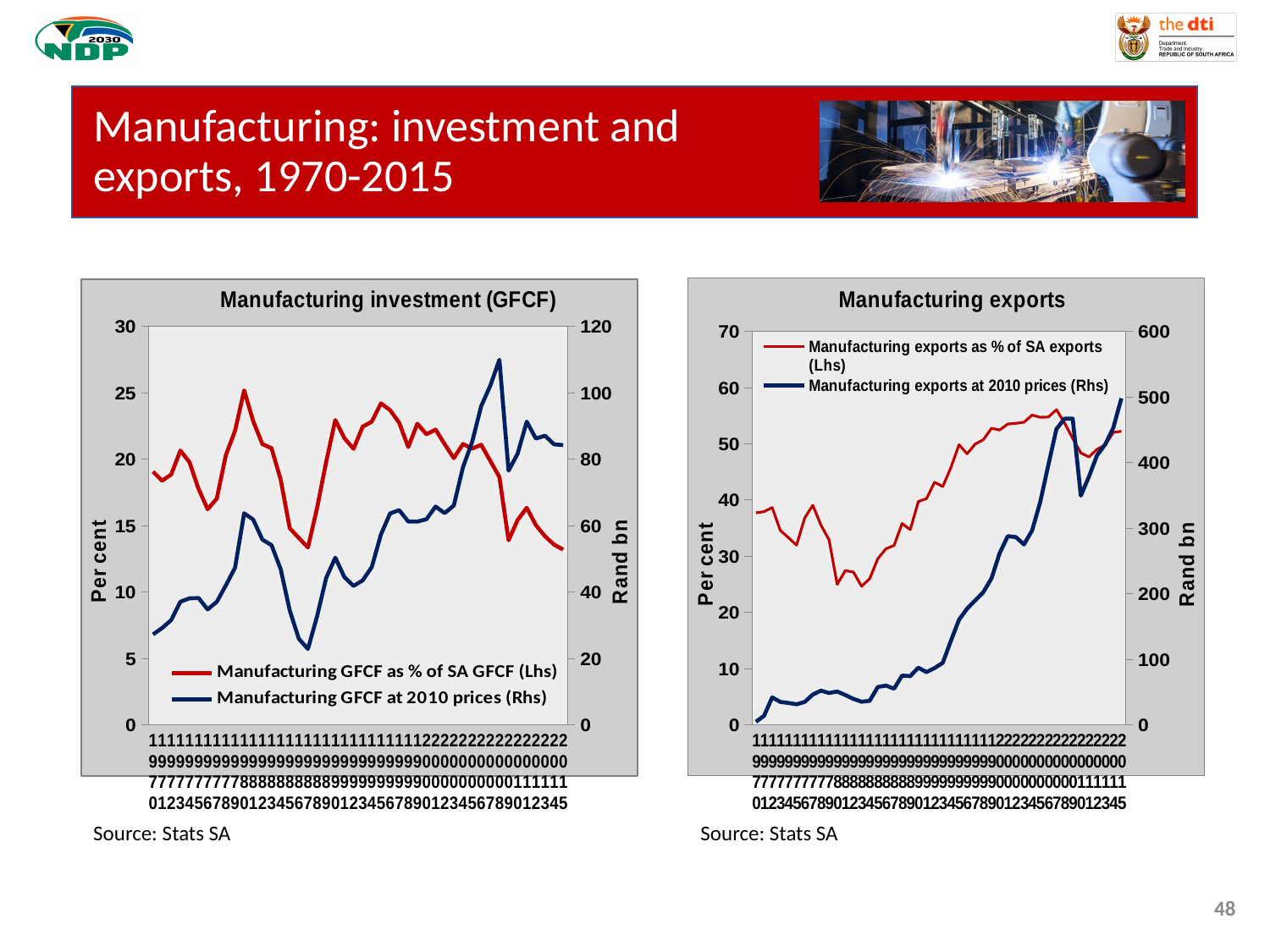
In the 'Manufacturing investment (GFCF)' chart, is the value of 'Manufacturing GFCF at 2010 prices (Rhs)' in 2015 greater or less than 60? greater In the 'Manufacturing exports' chart, is the value of 'Manufacturing exports at 2010 prices (Rhs)' in 2015 greater or less than 400? greater In the 'Manufacturing exports' chart, is the value of 'Manufacturing exports at 2010 prices (Rhs)' in 1970 greater or less than 100? less What kind of chart is the 'Manufacturing investment (GFCF)' chart? line chart How many series does the legend of the 'Manufacturing investment (GFCF)' chart list? 2 In the 'Manufacturing investment (GFCF)' chart, what is the label of the right-hand vertical axis? Rand bn In the 'Manufacturing exports' chart, which series is drawn in red? Manufacturing exports as % of SA exports (Lhs) In the 'Manufacturing exports' chart, does the 'Manufacturing exports at 2010 prices (Rhs)' series rise or fall overall from 1970 to 2015? rise How many series does the legend of the 'Manufacturing exports' chart list? 2 In the 'Manufacturing investment (GFCF)' chart, does the 'Manufacturing GFCF as % of SA GFCF (Lhs)' series rise or fall overall from 1970 to 2015? fall What kind of chart is the 'Manufacturing exports' chart? line chart